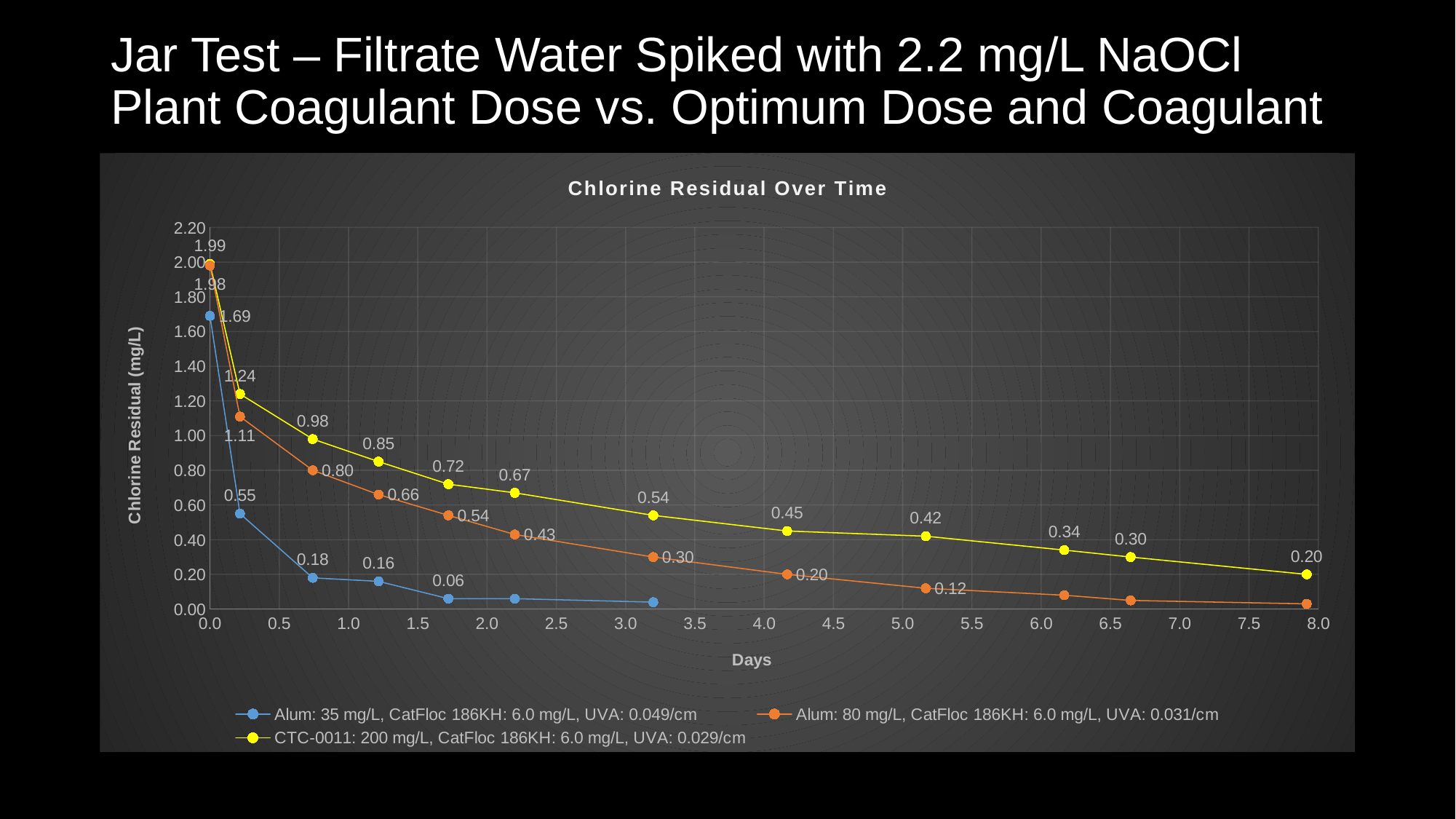
What is the difference between the first two labelled values of the Alum: 35 mg/L series (1.69 and 0.55)? 1.14 What is the value of the last point of the CTC-0011: 200 mg/L series? 0.20 What is the label of the x axis? Days Is the value of the last point of the Alum: 80 mg/L series greater or less than 0.20? less What is the title of the chart? Chlorine Residual Over Time How many series does the legend list? 3 What kind of chart is shown on the slide? line chart What is the value of the first point (day 0.0) of the Alum: 35 mg/L series? 1.69 What is the value of the second labelled point of the Alum: 35 mg/L series? 0.55 At around day 3.2, which series has the larger chlorine residual, CTC-0011: 200 mg/L or Alum: 80 mg/L? CTC-0011: 200 mg/L What is the lowest labelled value on the Alum: 80 mg/L series? 0.12 What is the lowest labelled value on the Alum: 35 mg/L series? 0.06